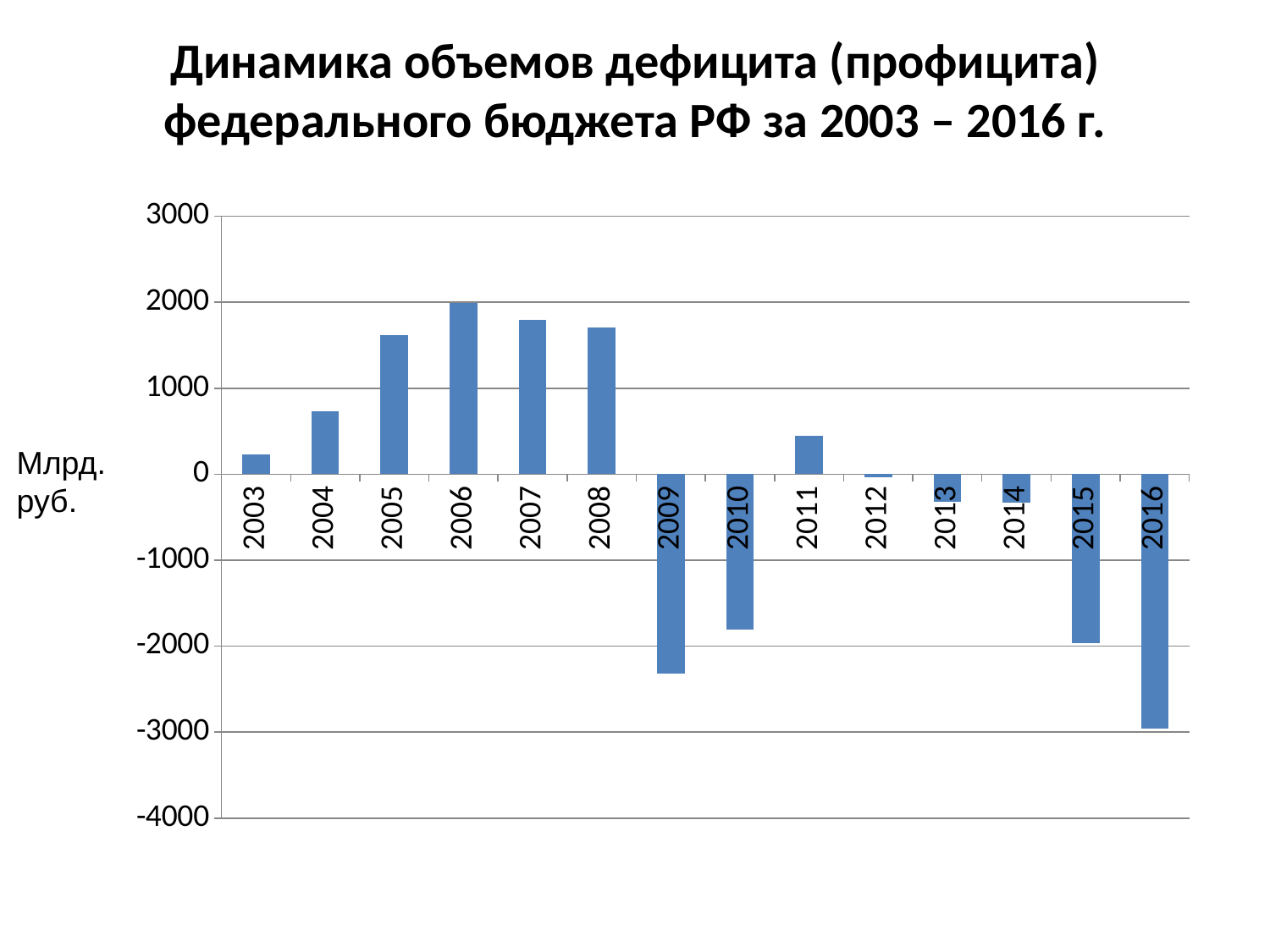
Which is larger, the value for 2005 or the value for 2004? 2005 Which year has the highest value on the chart? 2006 What kind of chart is shown on the slide? Bar chart Which is larger, the value for 2010 or the value for 2009? 2010 Is the value for 2004 greater or less than 1000? less Is the value for 2006 greater or less than 1000? greater Do the values rise or fall from 2003 to 2006? rise Which year has the lowest value on the chart? 2016 Is the value for 2009 greater or less than -2000? less How many years are plotted on the chart? 14 What unit is shown next to the vertical axis? Млрд. руб.